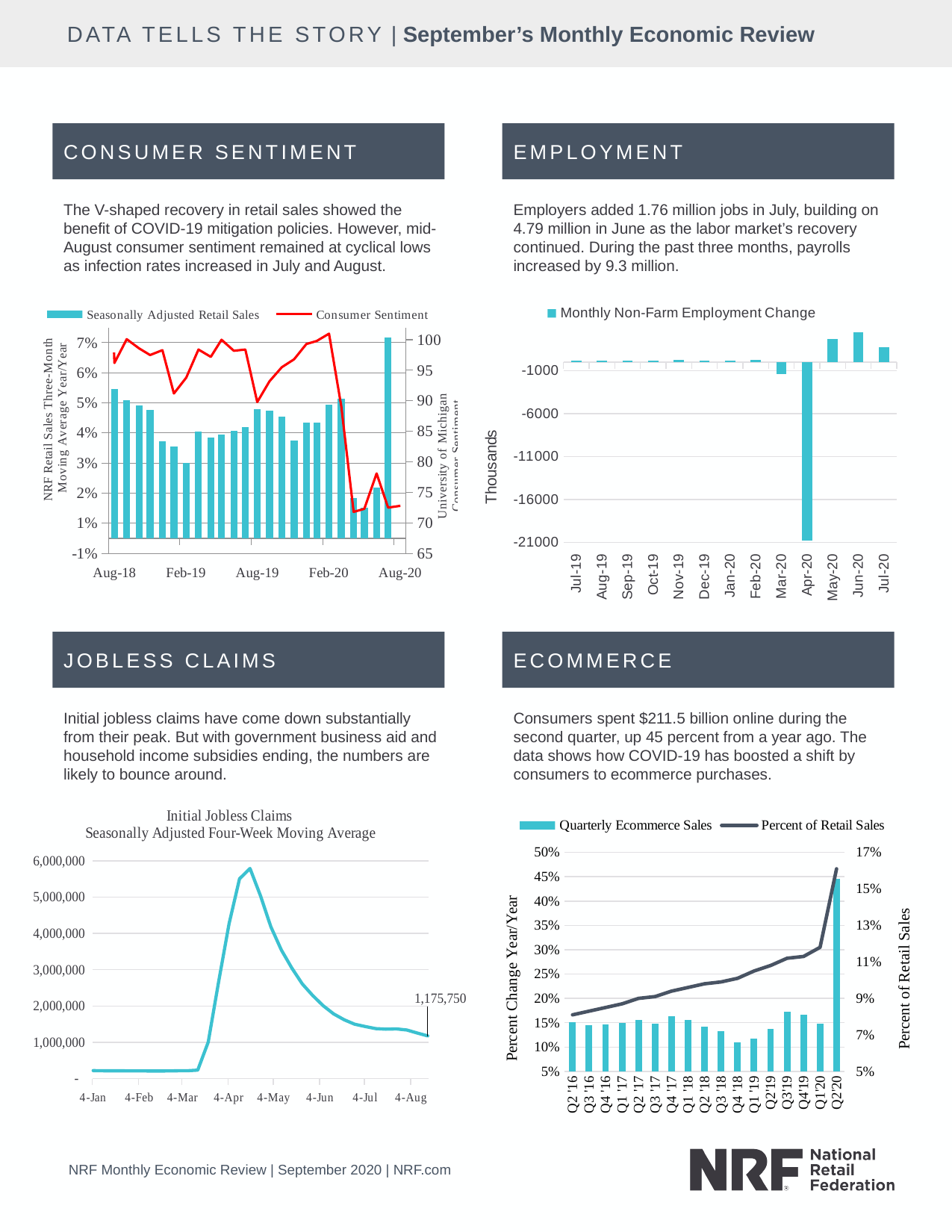
On the Consumer Sentiment chart (top left), how many series does the legend list? 2 On the Ecommerce chart (bottom right), which quarter has the highest Quarterly Ecommerce Sales bar? Q2'20 On the Initial Jobless Claims chart (bottom left), what kind of chart is it? line chart On the Ecommerce chart (bottom right), does the Percent of Retail Sales line rise or fall from Q2'16 to Q2'20? rise On the Consumer Sentiment chart (top left), is the Consumer Sentiment value at Aug-20 greater or less than 80? less On the Initial Jobless Claims chart (bottom left), is the peak value greater or less than 5,000,000? greater On the Employment chart (top right), is the value for Apr-20 greater or less than -16000? less On the Initial Jobless Claims chart (bottom left), what value is printed as the data label at the end of the line? 1,175,750 On the Employment chart (top right), which month has the lowest Monthly Non-Farm Employment Change? Apr-20 On the Employment chart (top right), how many months are shown on the x axis? 13 On the Consumer Sentiment chart (top left), what kind of chart is used for the Seasonally Adjusted Retail Sales series? bar chart On the Employment chart (top right), which month has the highest Monthly Non-Farm Employment Change? Jun-20